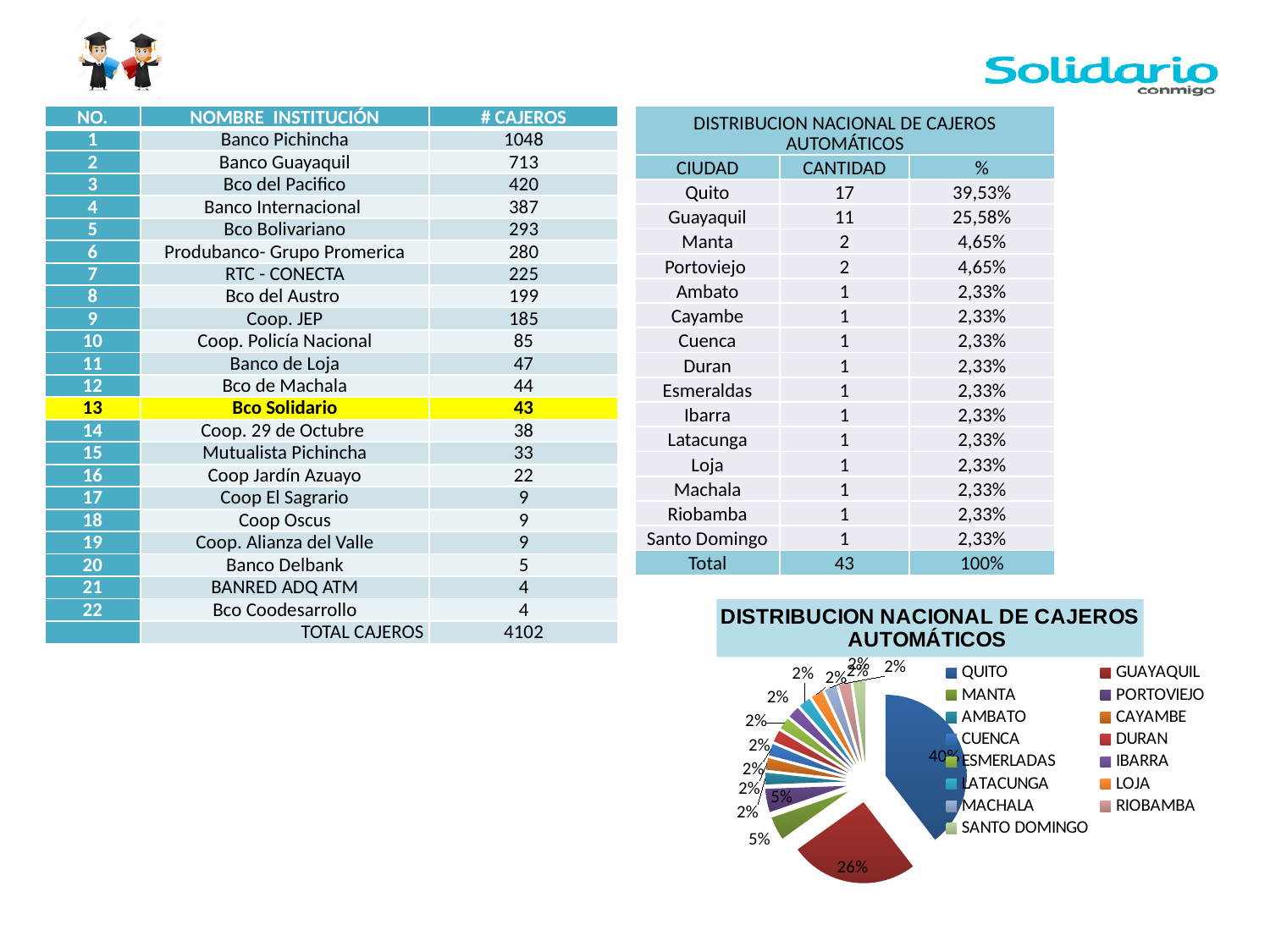
Which legend entry is listed first in the pie chart's legend? QUITO What percentage of the pie chart does GUAYAQUIL represent? 26% What percentage of the pie chart does QUITO represent? 40% What is the title of the chart on the slide? DISTRIBUCION NACIONAL DE CAJEROS AUTOMÁTICOS How many cities are listed in the legend of the pie chart? 15 Is the GUAYAQUIL slice of the pie chart greater or less than 30%? less Is the QUITO slice of the pie chart greater or less than 30%? greater What kind of chart is shown on the slide? pie chart Which city has the largest slice in the pie chart? QUITO By how many percentage points does the QUITO slice exceed the GUAYAQUIL slice in the pie chart? 14 Which slice is larger in the pie chart, QUITO or GUAYAQUIL? QUITO